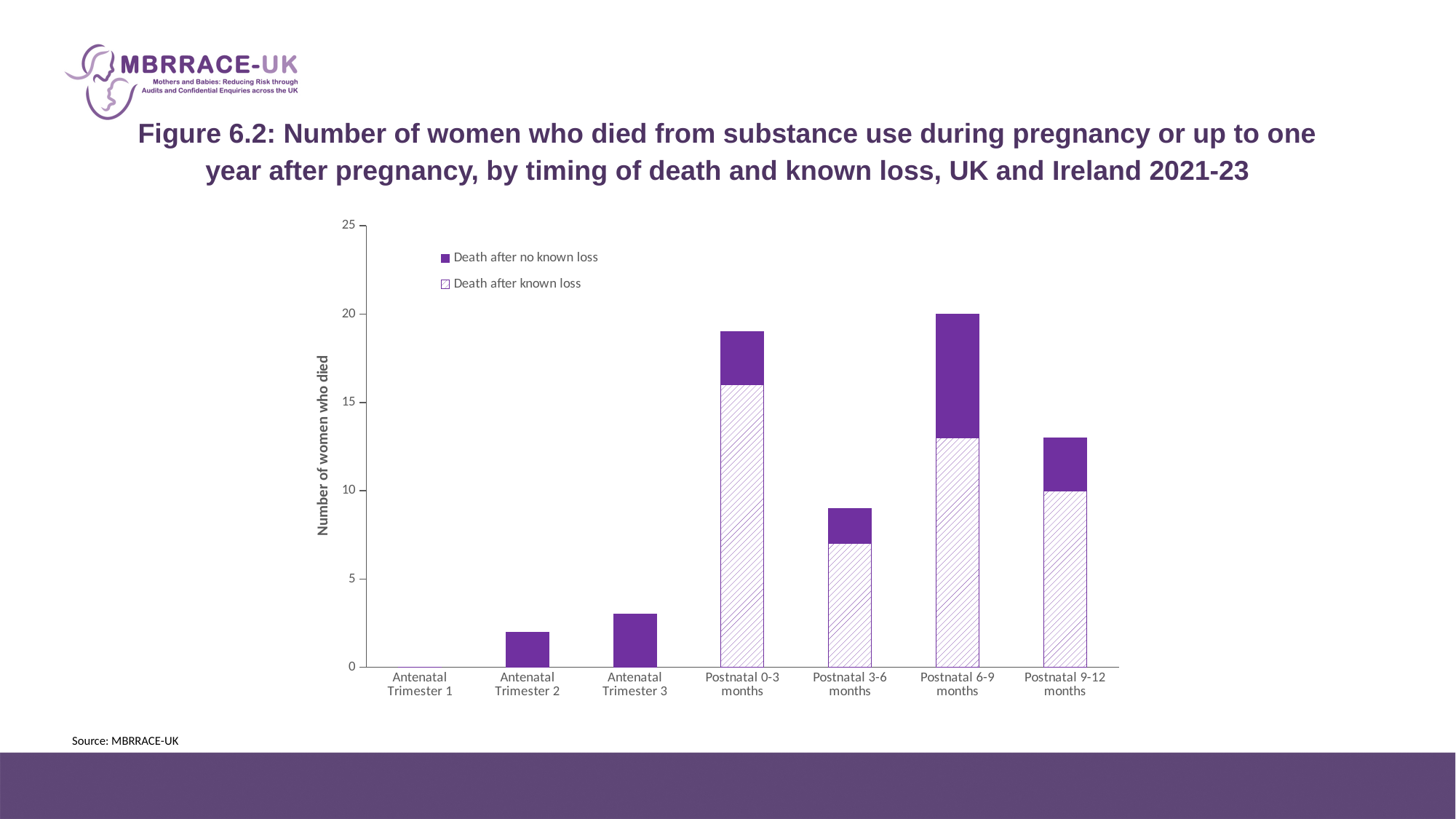
Which has the larger total: Postnatal 0-3 months or Postnatal 3-6 months? Postnatal 0-3 months Which has the larger total: Antenatal Trimester 2 or Antenatal Trimester 3? Antenatal Trimester 3 What kind of chart is shown on the slide? Bar chart Is the total value for Postnatal 0-3 months greater or less than 15? greater Is the 'Death after known loss' value for Postnatal 6-9 months greater or less than 10? greater Is the total value for Postnatal 3-6 months greater or less than 10? less What is the title of the y axis? Number of women who died Do the total values rise or fall from Antenatal Trimester 1 to Postnatal 0-3 months? Rise How many series does the legend list? 2 Which category has the lowest total number of women who died? Antenatal Trimester 1 How many timing-of-death categories are shown on the x axis? 7